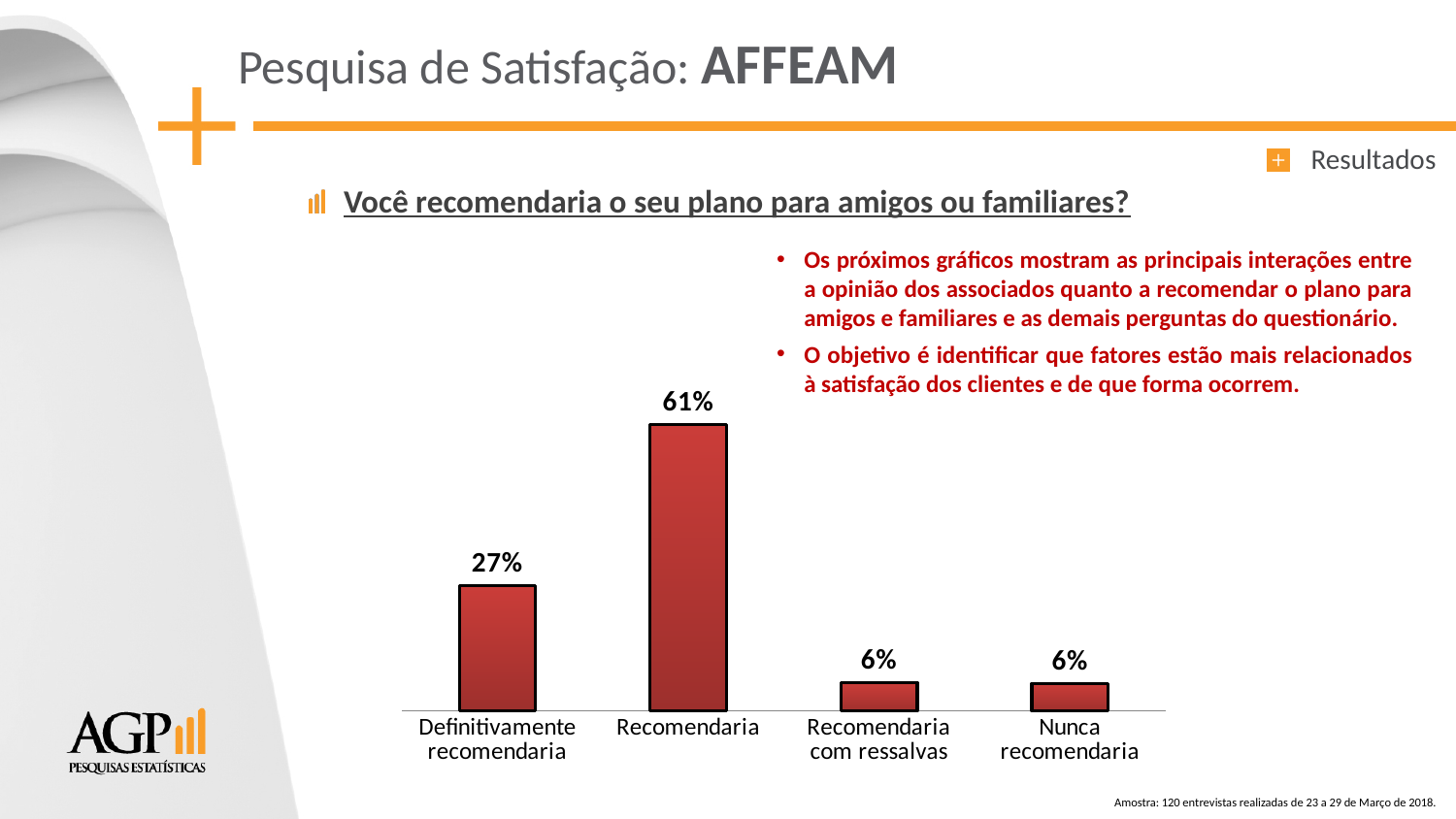
What is the combined value of "Recomendaria com ressalvas" and "Nunca recomendaria"? 12% Which is larger, the value for "Definitivamente recomendaria" or the value for "Recomendaria"? Recomendaria How many categories are shown in the chart? 4 What question does the chart on the slide answer? Você recomendaria o seu plano para amigos ou familiares? Which category has the highest value? Recomendaria What kind of chart is shown on the slide? Bar chart What is the value for "Recomendaria"? 61% What is the value for "Recomendaria com ressalvas"? 6% What is the value for "Nunca recomendaria"? 6% What is the value for "Definitivamente recomendaria"? 27% What is the difference between the values for "Definitivamente recomendaria" and "Nunca recomendaria"? 21% What is the difference between the values for "Recomendaria" and "Definitivamente recomendaria"? 34%